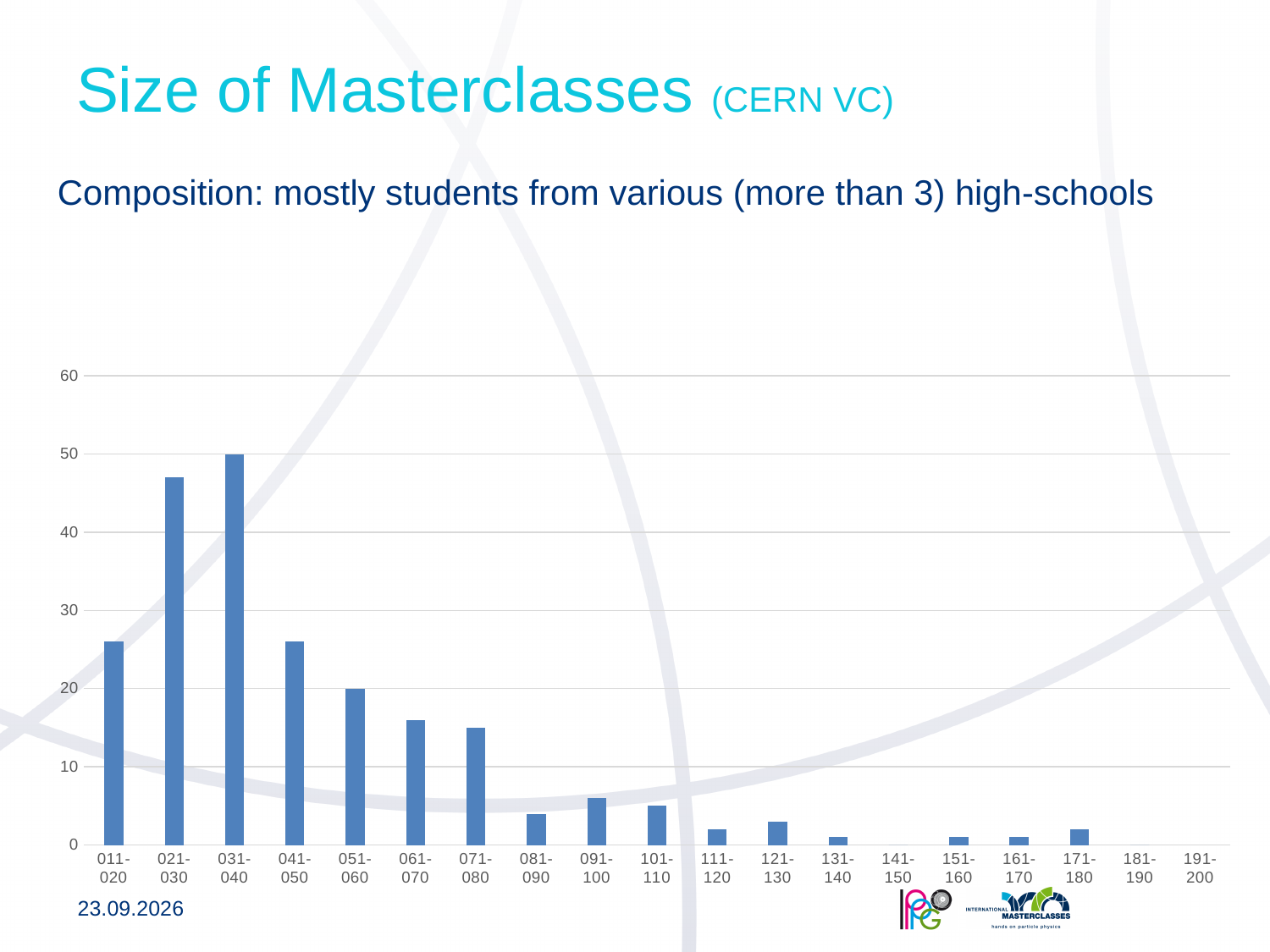
Is the value for 061-070 greater or less than 20? less How many size categories are shown along the x axis? 19 What kind of chart is shown on the slide? bar chart From the 031-040 category onward, do the values generally rise or fall along the x axis? fall Which has the larger value, 021-030 or 041-050? 021-030 What is the value for the 051-060 category? 20 Which size category has the highest bar? 031-040 What is the highest value labelled on the vertical axis? 60 Is the value for 081-090 greater or less than 10? less Is the value for 011-020 greater or less than 20? greater What is the value for the 031-040 category? 50